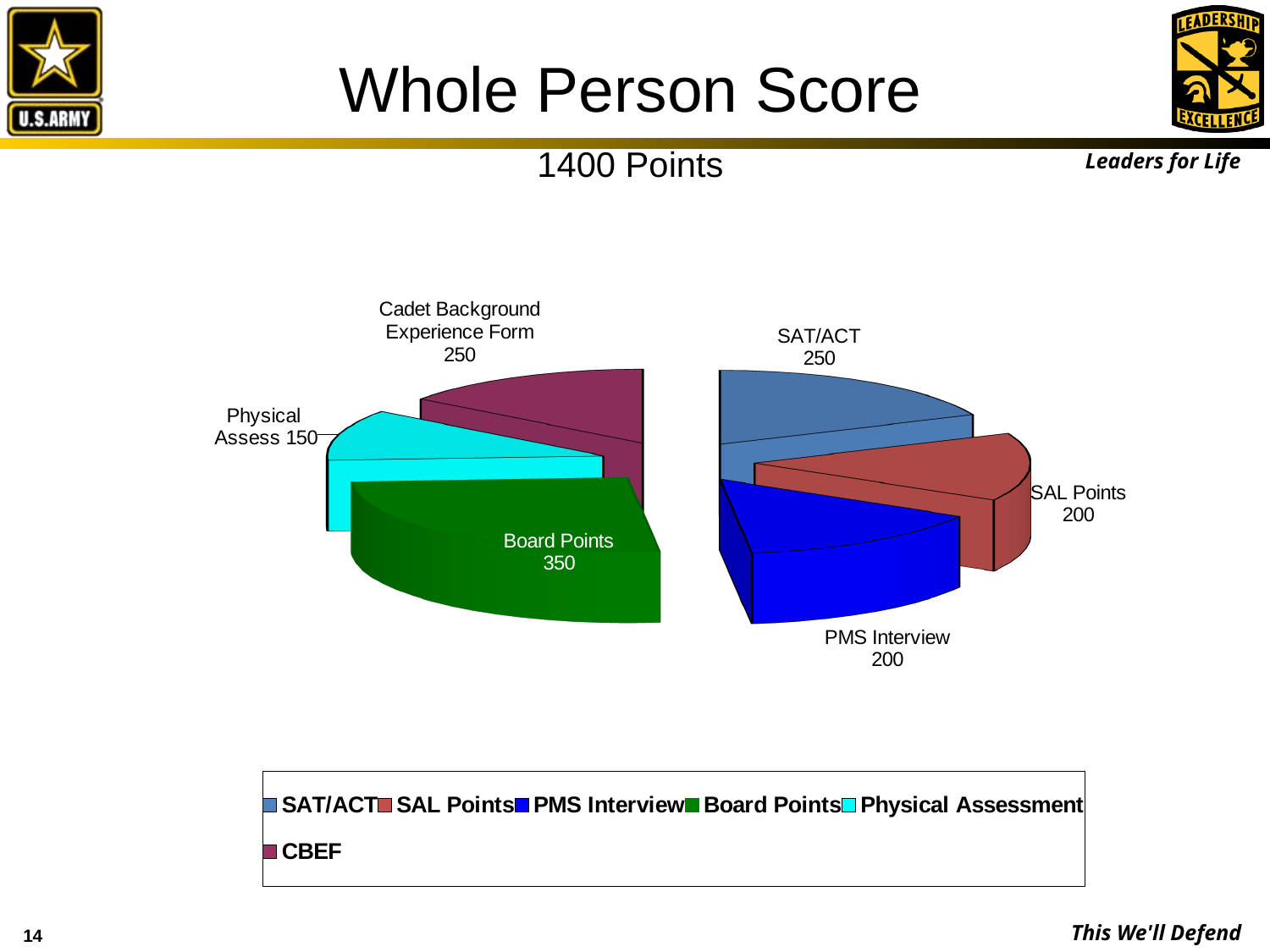
Which is larger, SAT/ACT or PMS Interview? SAT/ACT What type of chart is shown on the slide? pie chart How many points are allocated to Board Points? 350 What colour is the Board Points slice? green What is the value for SAT/ACT? 250 How many slices does the pie chart have? 6 Which category has the largest slice of the pie? Board Points What is the difference between Board Points and SAL Points? 150 Which category has the smallest slice of the pie? Physical Assess What is the value for Physical Assess? 150 What is the value for PMS Interview? 200 What share of the total 1400 points does Board Points represent? 25%